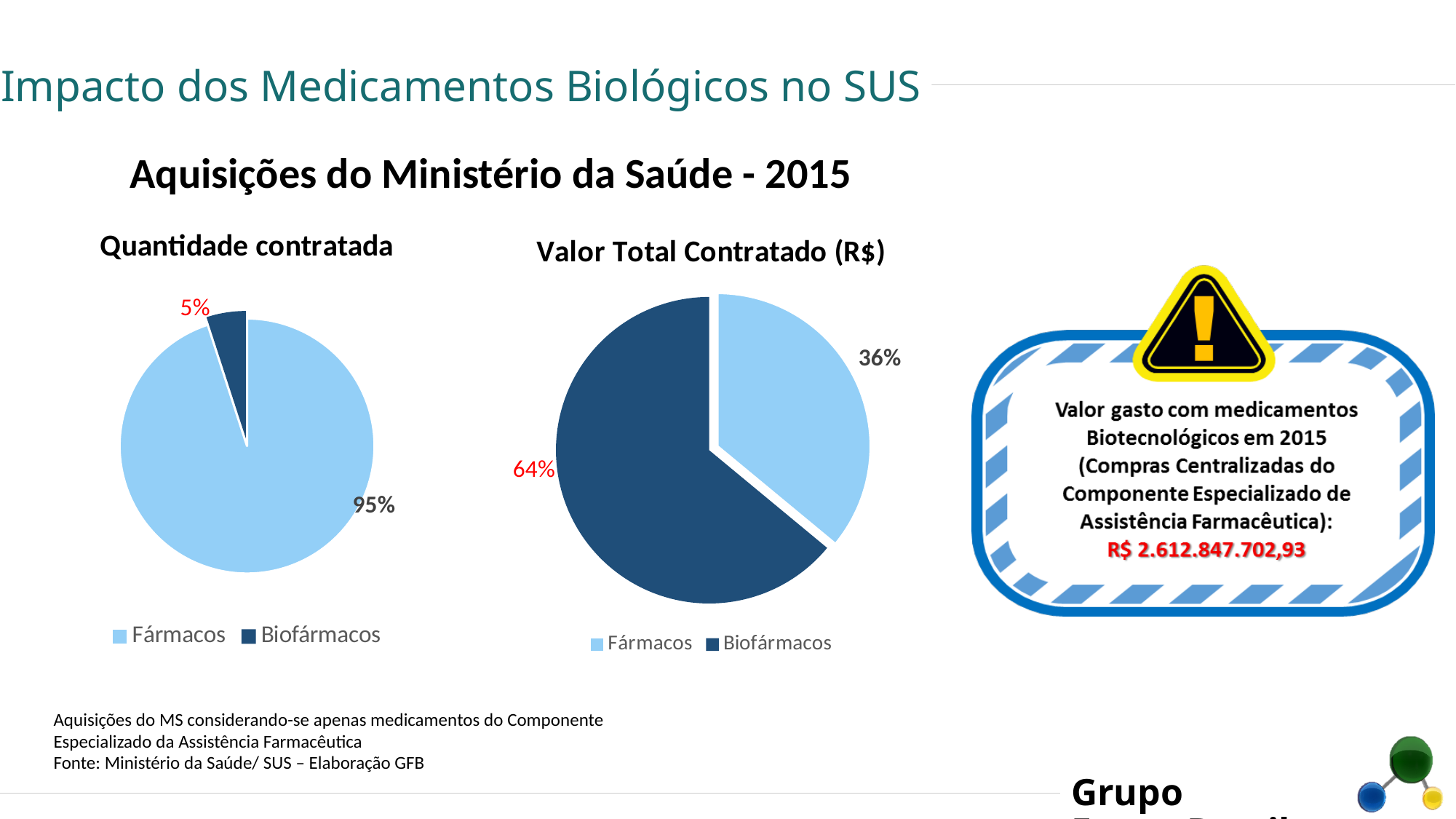
In the 'Valor Total Contratado (R$)' chart, which category has the smallest slice? Fármacos How many categories does the 'Valor Total Contratado (R$)' chart show? 2 In the 'Valor Total Contratado (R$)' chart, what share does Biofármacos have? 64% In the 'Valor Total Contratado (R$)' chart, what is the difference between the Biofármacos and Fármacos shares? 28% What type of chart is the 'Quantidade contratada' chart? Pie chart In the 'Quantidade contratada' chart, which category has the largest slice? Fármacos In the 'Quantidade contratada' chart, what share does Fármacos have? 95% In the 'Valor Total Contratado (R$)' chart, which is larger, Fármacos or Biofármacos? Biofármacos What colour represents Biofármacos in the legend of the 'Quantidade contratada' chart? Dark blue In the 'Quantidade contratada' chart, what is the difference between the Fármacos and Biofármacos shares? 90% In the 'Quantidade contratada' chart, what share does Biofármacos have? 5%